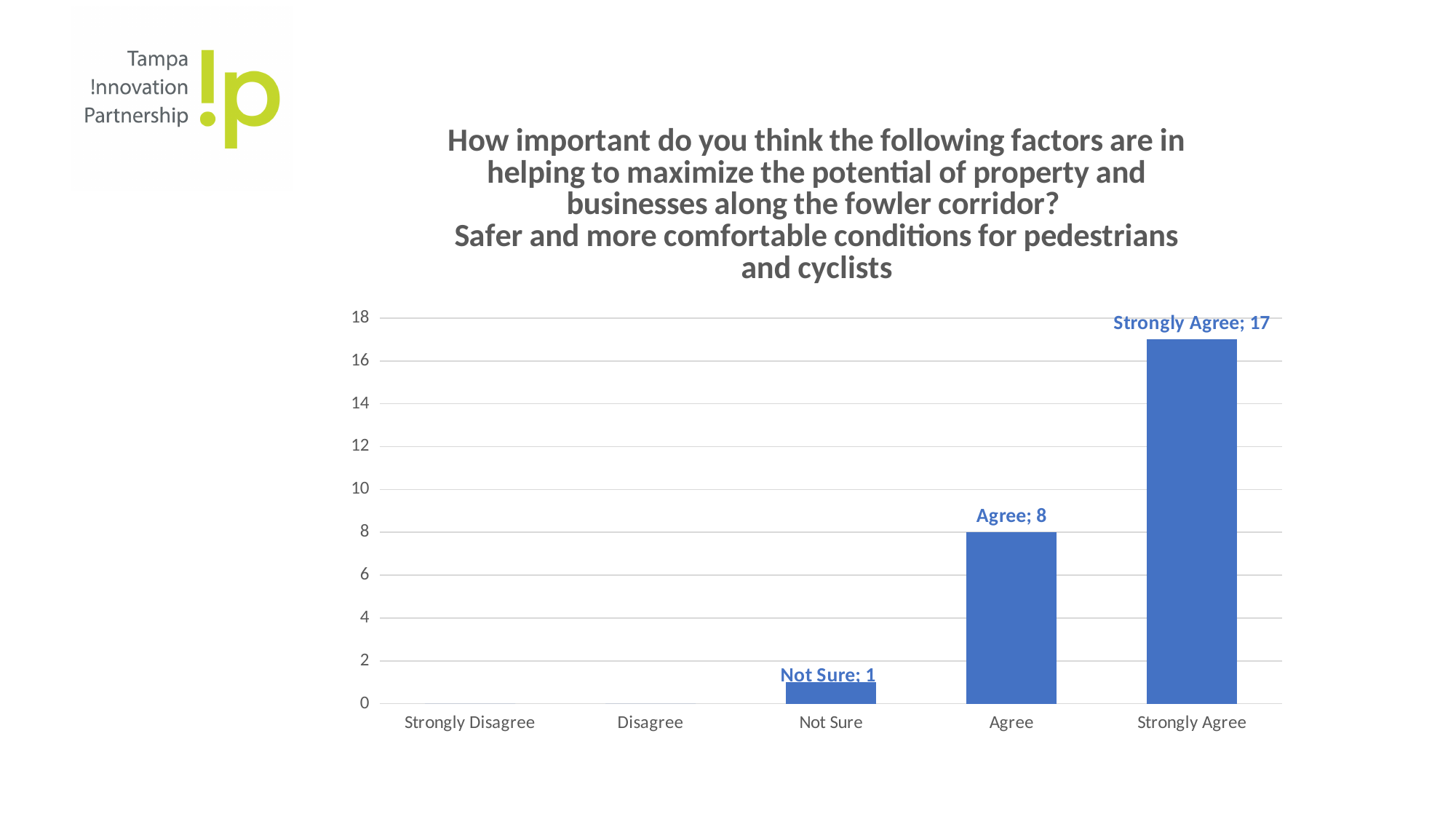
How many categories are shown on the x axis? 5 Is the value for Strongly Agree greater or less than 16? greater What is the difference between the values for Strongly Agree and Agree? 9 Which category has the highest value? Strongly Agree What is the value for Agree? 8 What is the highest value shown on the y axis? 18 Do the values rise or fall from Not Sure to Strongly Agree along the x axis? Rise What is the value for Not Sure? 1 What kind of chart is shown on the slide? Bar chart Which labelled bar has the lowest value? Not Sure Which is larger, the value for Agree or the value for Not Sure? Agree What is the value for Strongly Agree? 17